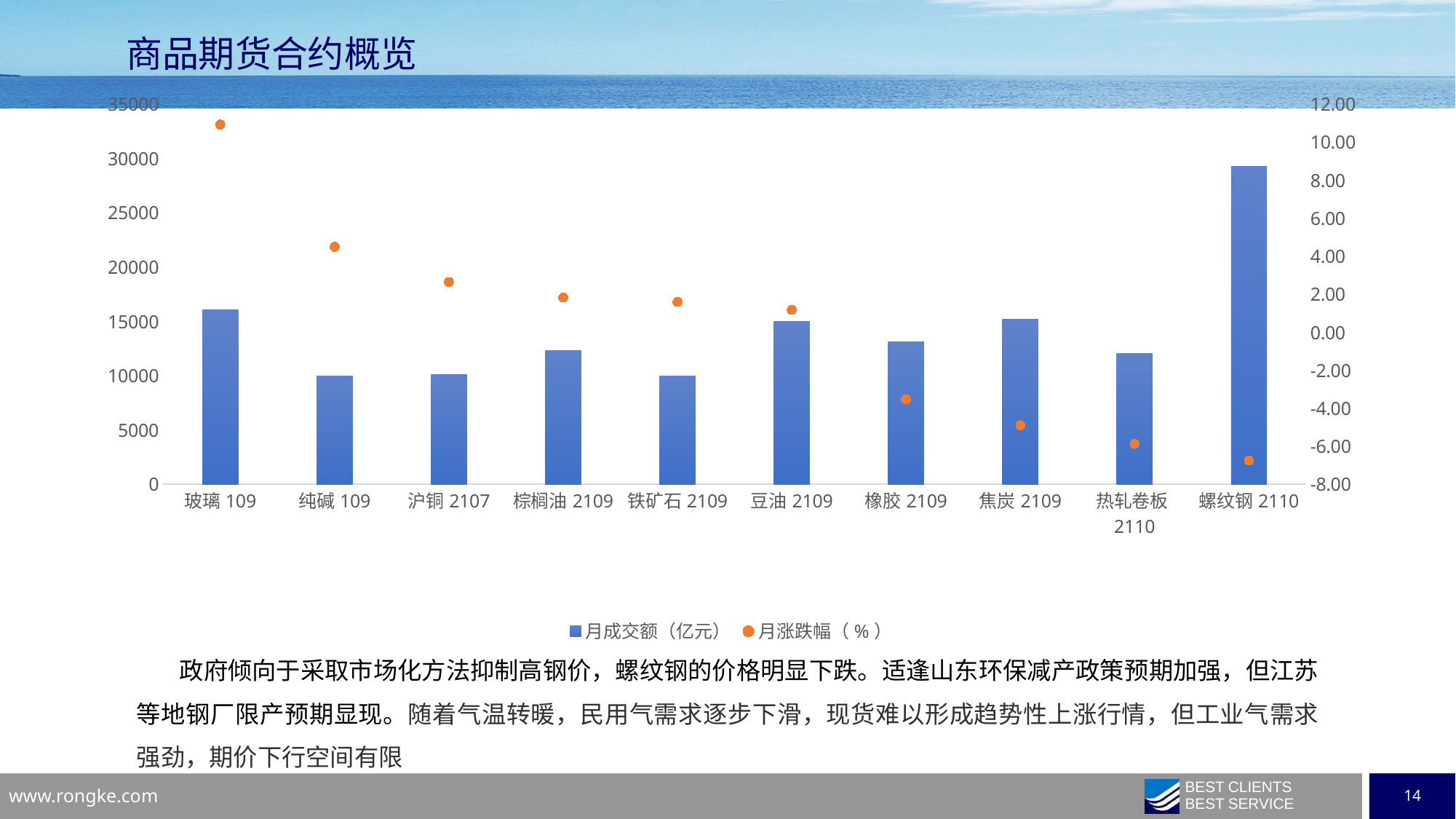
Which contract has the lowest 月涨跌幅（%） value? 螺纹钢 2110 Which contract has the highest 月涨跌幅（%） value? 玻璃 109 How many series does the chart legend list? 2 Is the 月涨跌幅（%） value for 玻璃 109 greater or less than 10.00? greater Is the 月涨跌幅（%） value for 焦炭 2109 greater or less than 0.00? less What kind of chart is shown on the slide? A bar chart combined with a dot (marker) series on a secondary axis Which contract has the highest 月成交额（亿元） bar? 螺纹钢 2110 What are the two legend entries of the chart? 月成交额（亿元） and 月涨跌幅（%） Is the 月成交额（亿元） bar for 纯碱 109 greater or less than 15000? less How many categories (contracts) are shown on the x axis of the chart? 10 Which has the larger 月成交额（亿元） bar, 玻璃 109 or 纯碱 109? 玻璃 109